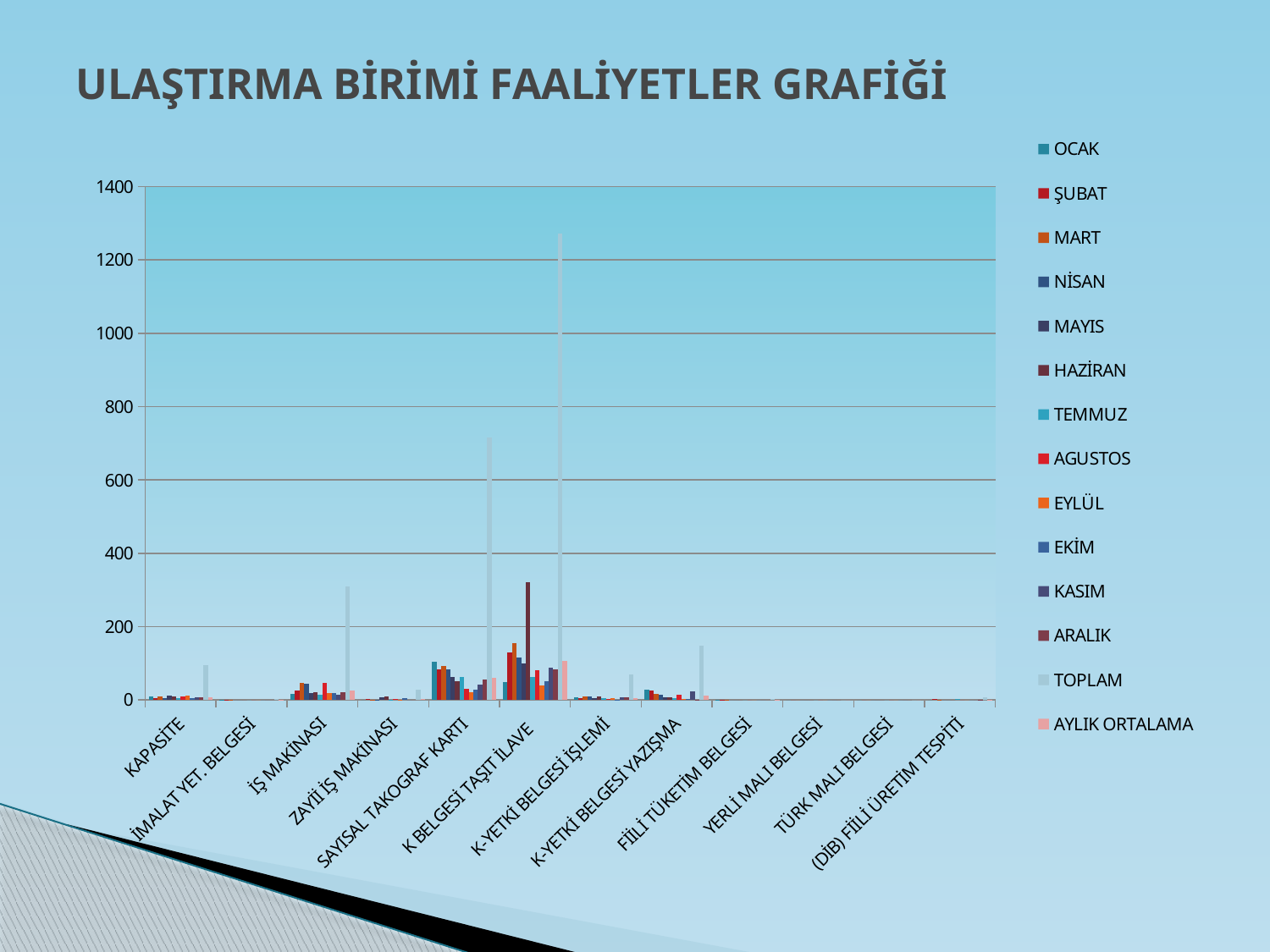
What kind of chart is shown on the slide? bar chart How many categories are shown on the x axis? 12 Which is larger, the TOPLAM value for K BELGESİ TAŞIT İLAVE or the TOPLAM value for SAYISAL TAKOGRAF KARTI? K BELGESİ TAŞIT İLAVE Is the TOPLAM value for SAYISAL TAKOGRAF KARTI greater or less than 600? greater How many series does the legend list? 14 What is the title of the chart? ULAŞTIRMA BİRİMİ FAALİYETLER GRAFİĞİ Is the TOPLAM value for K BELGESİ TAŞIT İLAVE greater or less than 1200? greater Is the TOPLAM value for ZAYİİ İŞ MAKİNASI greater or less than 400? less What is the highest value shown on the y axis? 1400 Which is larger, the TOPLAM value for ZAYİİ İŞ MAKİNASI or the TOPLAM value for KAPASİTE? KAPASİTE Which category has the highest TOPLAM bar? K BELGESİ TAŞIT İLAVE